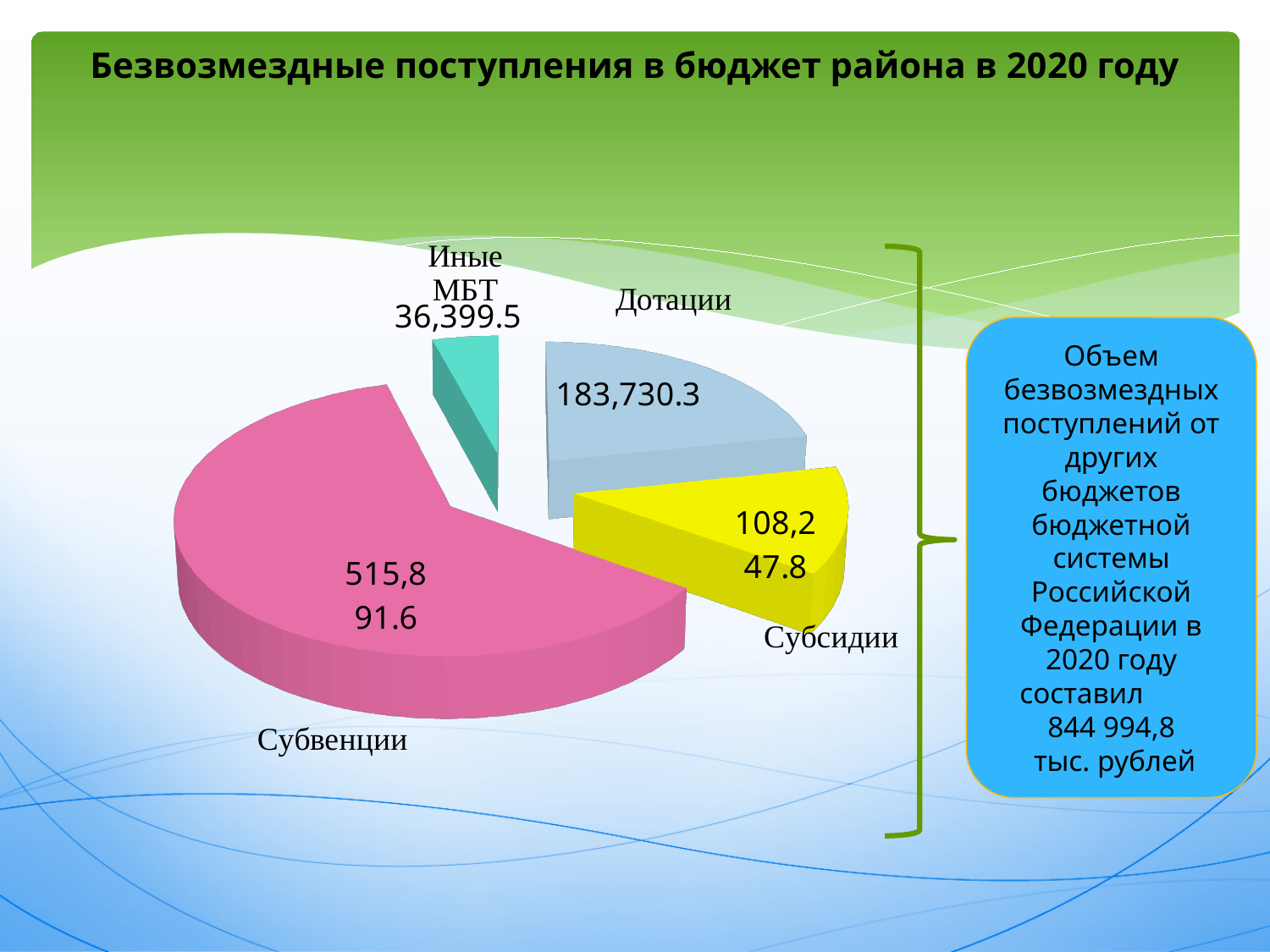
What is the value shown for Дотации? 183,730.3 Which is larger, Субвенции or Дотации? Субвенции What is the difference between the values for Дотации and Иные МБТ? 147,330.8 Which category has the largest slice of the pie? Субвенции What type of chart is shown on the slide? Pie chart Which is larger, Дотации or Субсидии? Дотации What is the title of the slide containing the chart? Безвозмездные поступления в бюджет района в 2020 году What colour is the Субвенции slice? Pink Which category has the smallest slice of the pie? Иные МБТ What is the value shown for Иные МБТ? 36,399.5 How many categories (slices) does the pie chart have? 4